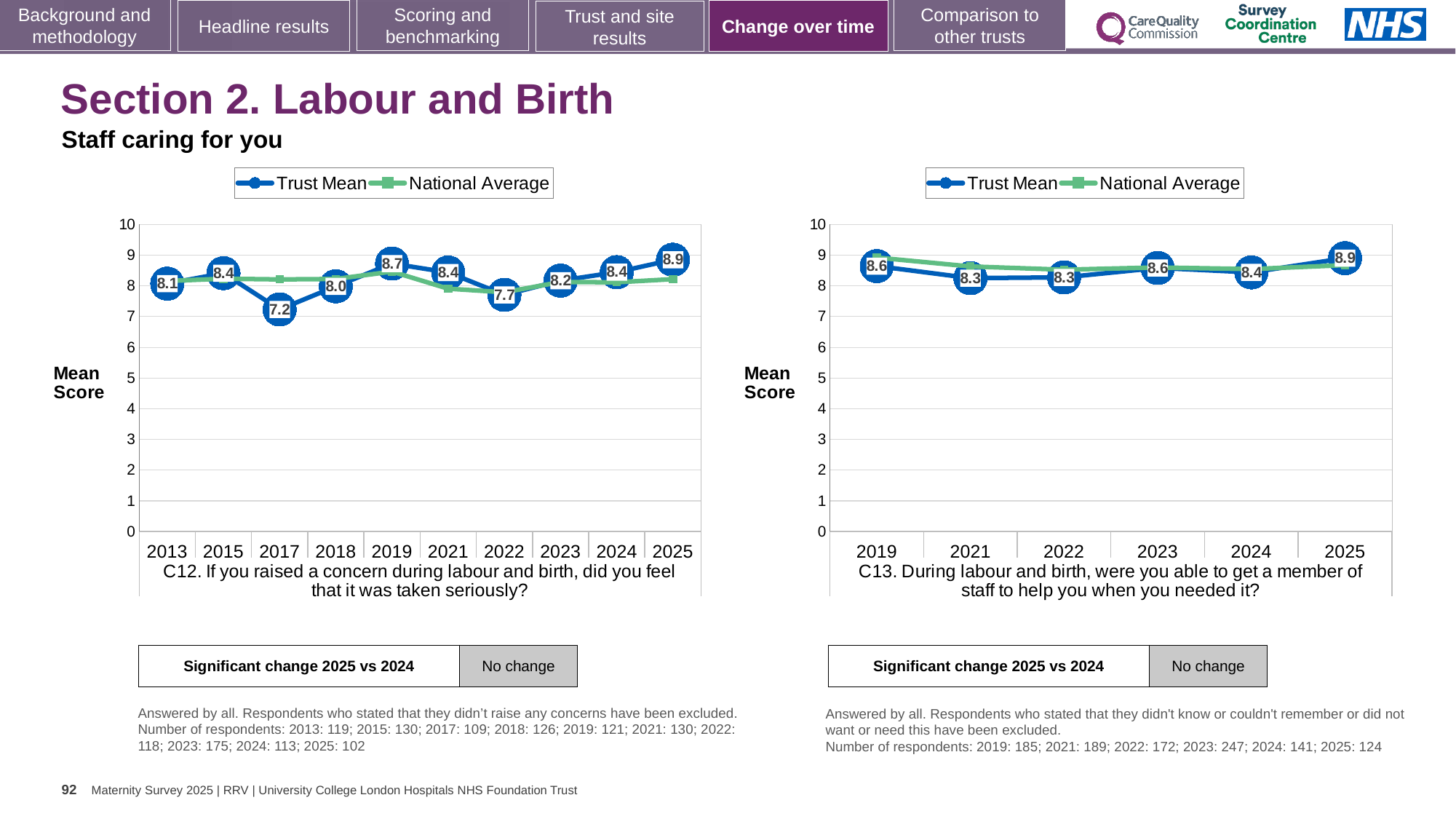
In the C13 chart on the right, how many series does the legend list? 2 In the C12 chart on the left, how many years are plotted on the x axis? 10 In the C12 chart on the left, which year has the highest Trust Mean score? 2025 In the C13 chart on the right, is the Trust Mean score for 2021 greater or less than 9? less In the C12 chart on the left, is the Trust Mean score for 2022 larger or smaller than the score for 2023? smaller In the C12 chart on the left, which year has the lowest Trust Mean score? 2017 In the C13 chart on the right, which year has the highest Trust Mean score? 2025 In the C13 chart on the right, what is the Trust Mean score for 2023? 8.6 What kind of chart is the C13 chart on the right? Line chart In the C12 chart on the left, what is the difference between the Trust Mean scores for 2025 and 2024? 0.5 In the C12 chart on the left, what is the Trust Mean score for 2017? 7.2 In the C12 chart on the left, what is the Trust Mean score for 2025? 8.9